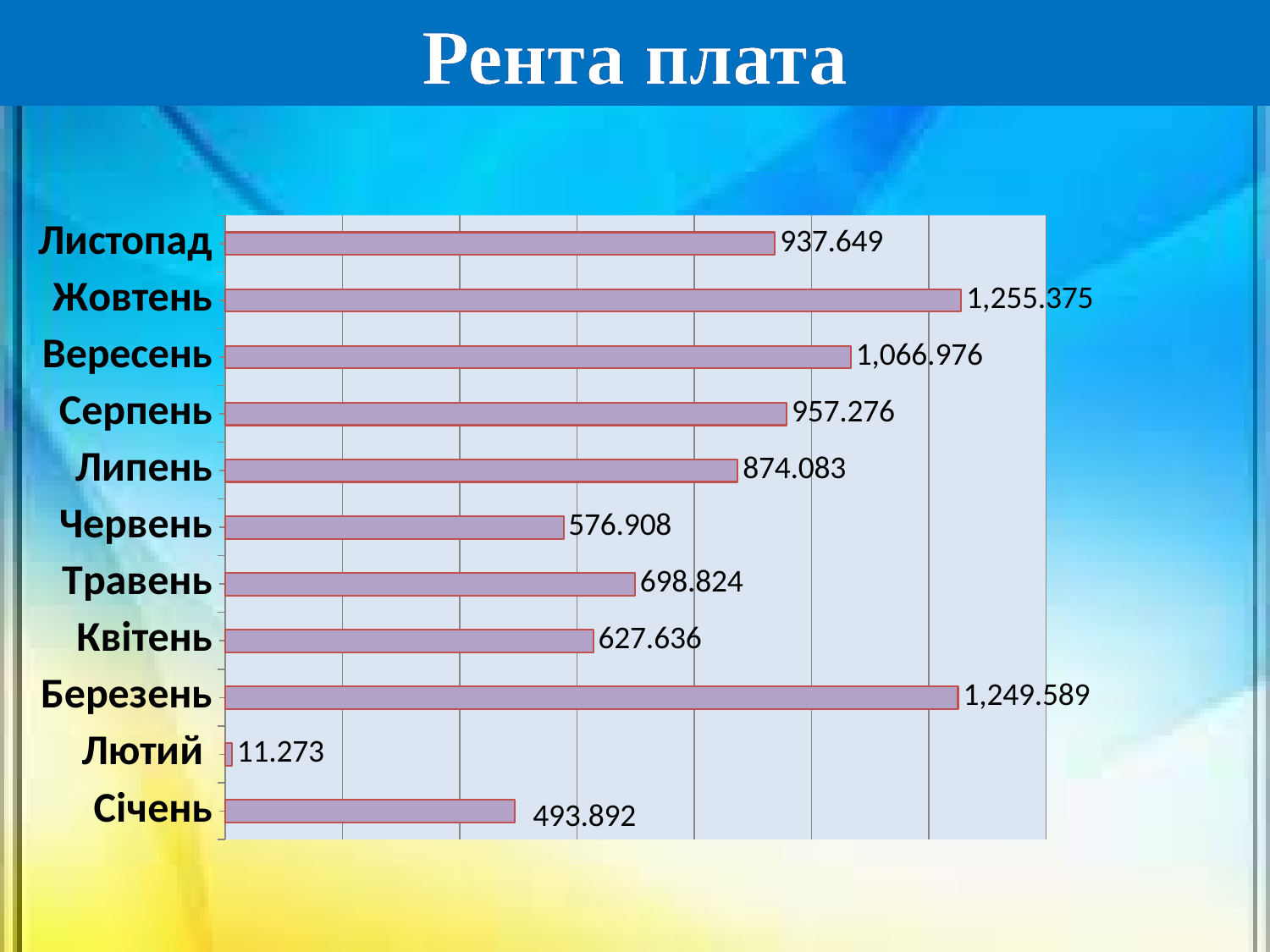
What is the value for Лютий? 11.273 What is the value for Вересень? 1,066.976 Which month has the lowest value? Лютий What is the value for Жовтень? 1,255.375 What kind of chart is shown on the slide? Bar chart What is the difference between the values for Травень and Квітень? 71.188 How many months are shown in the chart? 11 What is the value for Січень? 493.892 Which is larger, the value for Серпень or the value for Листопад? Серпень Which month has the highest value? Жовтень What is the difference between the values for Жовтень and Березень? 5.786 Which is larger, the value for Червень or the value for Липень? Липень